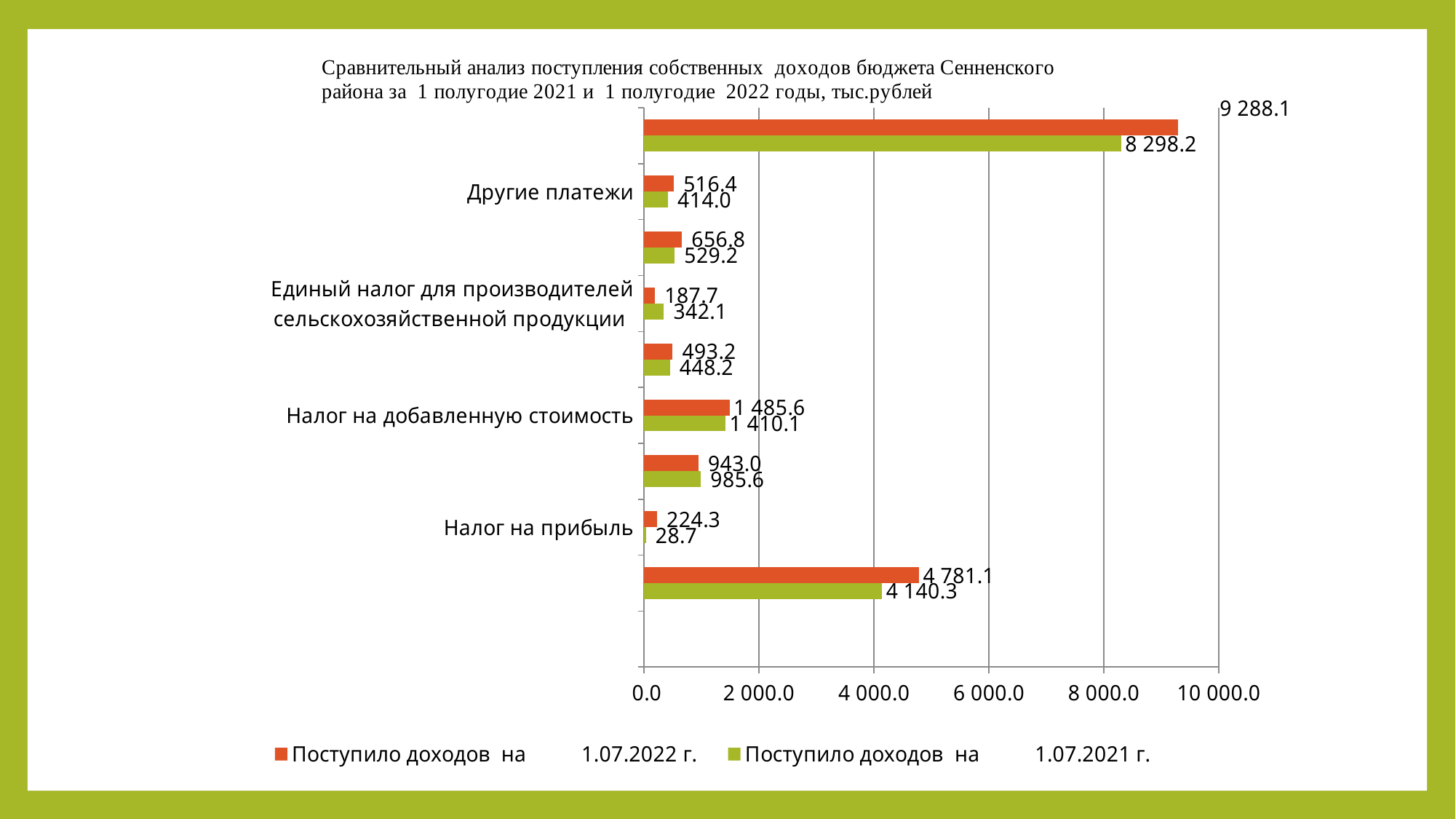
Which colour represents Поступило доходов на 1.07.2021 г. in the legend? green What kind of chart is shown on the slide? bar chart What is the value for Налог на прибыль for Поступило доходов на 1.07.2021 г.? 28.7 What is the value for Единый налог для производителей сельскохозяйственной продукции for Поступило доходов на 1.07.2021 г.? 342.1 What is the value for Налог на добавленную стоимость for Поступило доходов на 1.07.2022 г.? 1 485.6 For Единый налог для производителей сельскохозяйственной продукции, which series has the larger value: 1.07.2022 г. or 1.07.2021 г.? Поступило доходов на 1.07.2021 г. What is the difference between the 1.07.2022 and 1.07.2021 values for Другие платежи? 102.4 Is the value for Налог на добавленную стоимость on 1.07.2022 г. greater or less than 2 000.0? less What is the highest value shown on the chart? 9 288.1 How many series does the legend list? 2 What is the value for Другие платежи for Поступило доходов на 1.07.2022 г.? 516.4 What is the difference between the 1.07.2022 and 1.07.2021 values for Налог на прибыль? 195.6